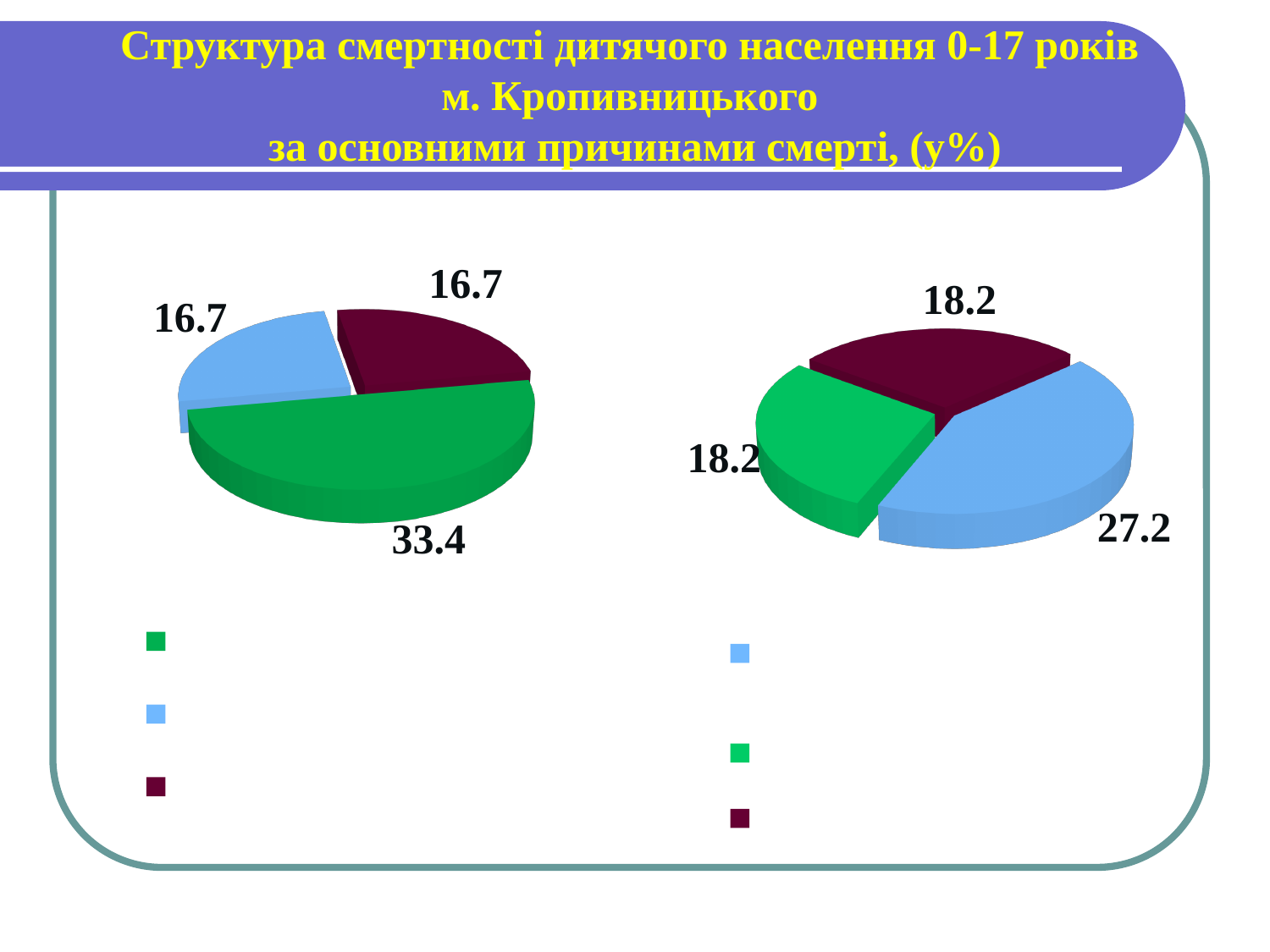
In the right pie chart, what value is shown for the green slice? 18.2 In the left pie chart, what value is shown for the green slice? 33.4 In the left pie chart, what value is shown for the dark maroon slice? 16.7 In the right pie chart, what is the difference between the light blue slice and the green slice? 9.0 How many slices does the right pie chart have? 3 What kind of chart is the left chart on the slide? pie chart In the left pie chart, what is the difference between the green slice and the light blue slice? 16.7 In the left pie chart, what value is shown for the light blue slice? 16.7 In the right pie chart, what value is shown for the light blue slice? 27.2 In the left pie chart, which slice has the largest value? the green slice (33.4) What kind of chart is the right chart on the slide? pie chart In the right pie chart, which slice has the largest value? the light blue slice (27.2)